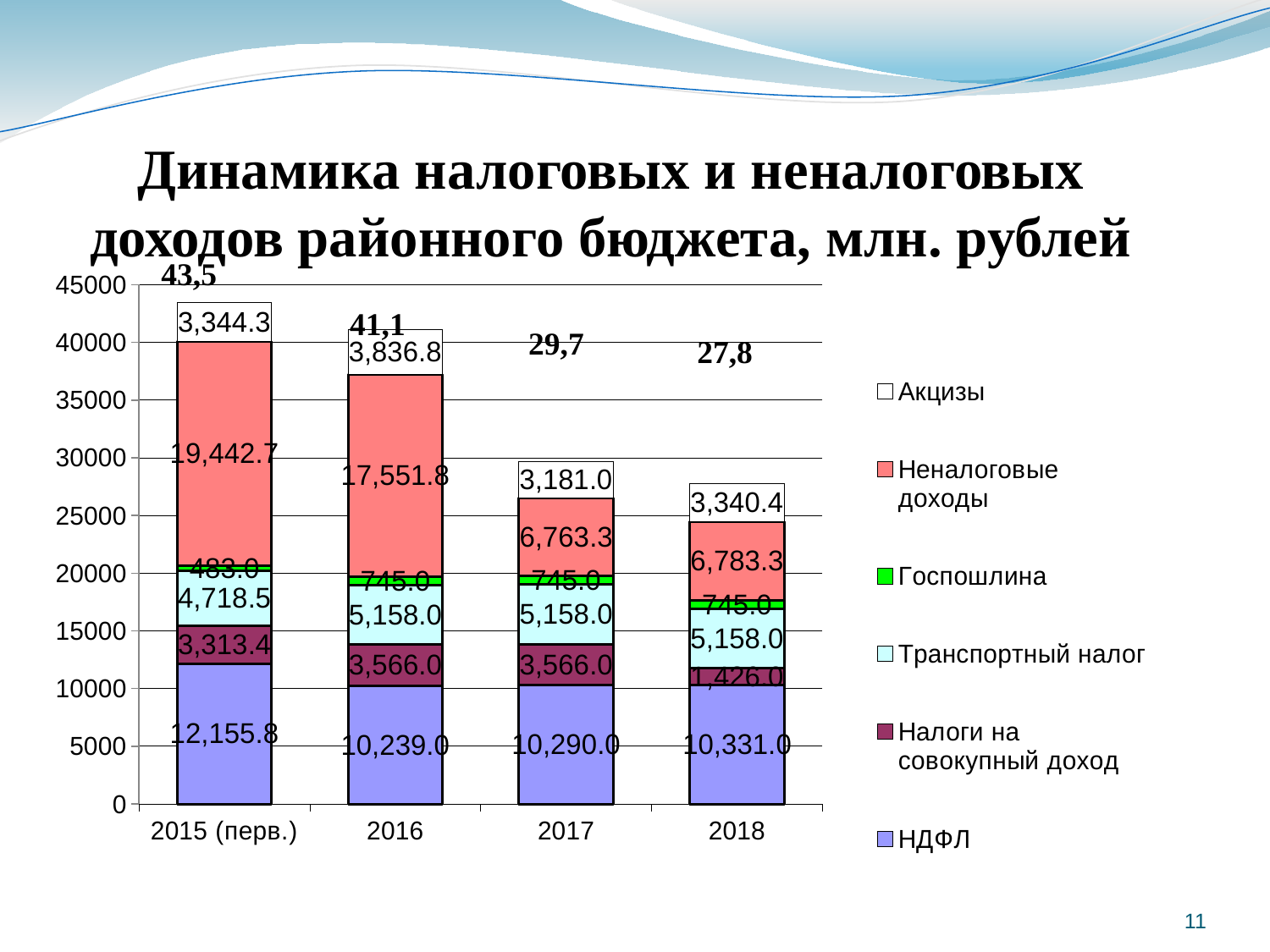
What type of chart is shown on the slide? Stacked bar chart Do the total bar heights rise or fall from 2015 (перв.) to 2018? fall What is the value of Акцизы for 2018? 3,340.4 What is the value of НДФЛ for 2015 (перв.)? 12,155.8 In which year is НДФЛ the highest? 2015 (перв.) In which year is Налоги на совокупный доход the lowest? 2018 Which is larger: Неналоговые доходы in 2016 or in 2017? 2016 What is the value of Неналоговые доходы for 2016? 17,551.8 How many series does the legend list? 6 How many categories (years) are shown on the x axis? 4 Is the total height of the 2018 bar greater or less than 30000? less What is the difference between НДФЛ in 2015 (перв.) and in 2016? 1,916.8